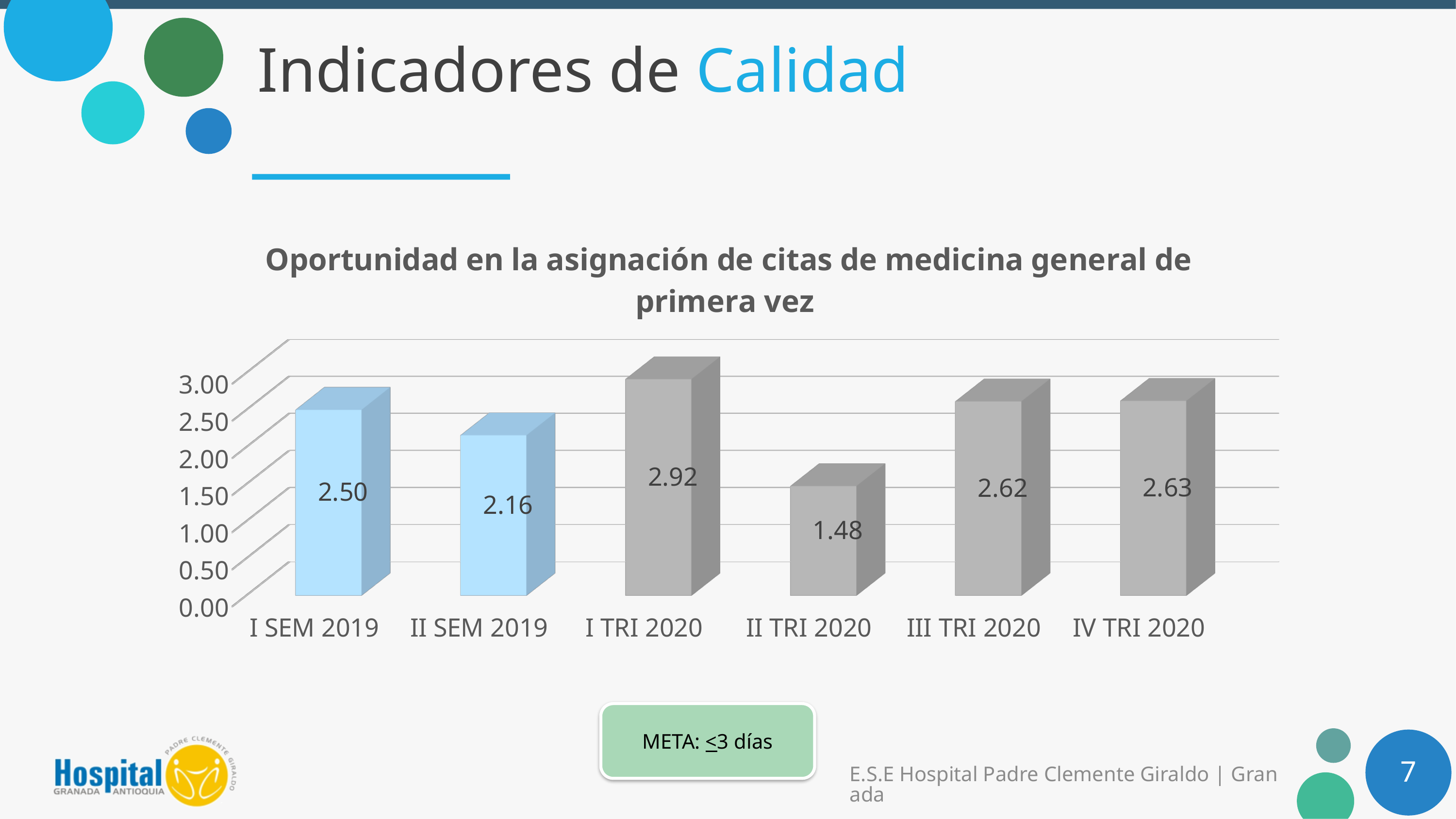
What target (META) is stated below the chart? ≤3 días What is the value for II TRI 2020? 1.48 Which category has the highest value? I TRI 2020 Is the value for I TRI 2020 greater or less than 3.00? less Which category has the lowest value? II TRI 2020 What is the difference between the values for I SEM 2019 and II SEM 2019? 0.34 What is the difference between the values for I TRI 2020 and II TRI 2020? 1.44 What kind of chart is shown on the slide? bar chart What is the value for I SEM 2019? 2.50 What is the value for IV TRI 2020? 2.63 Which is larger, the value for II SEM 2019 or the value for III TRI 2020? III TRI 2020 How many categories are shown on the x axis? 6